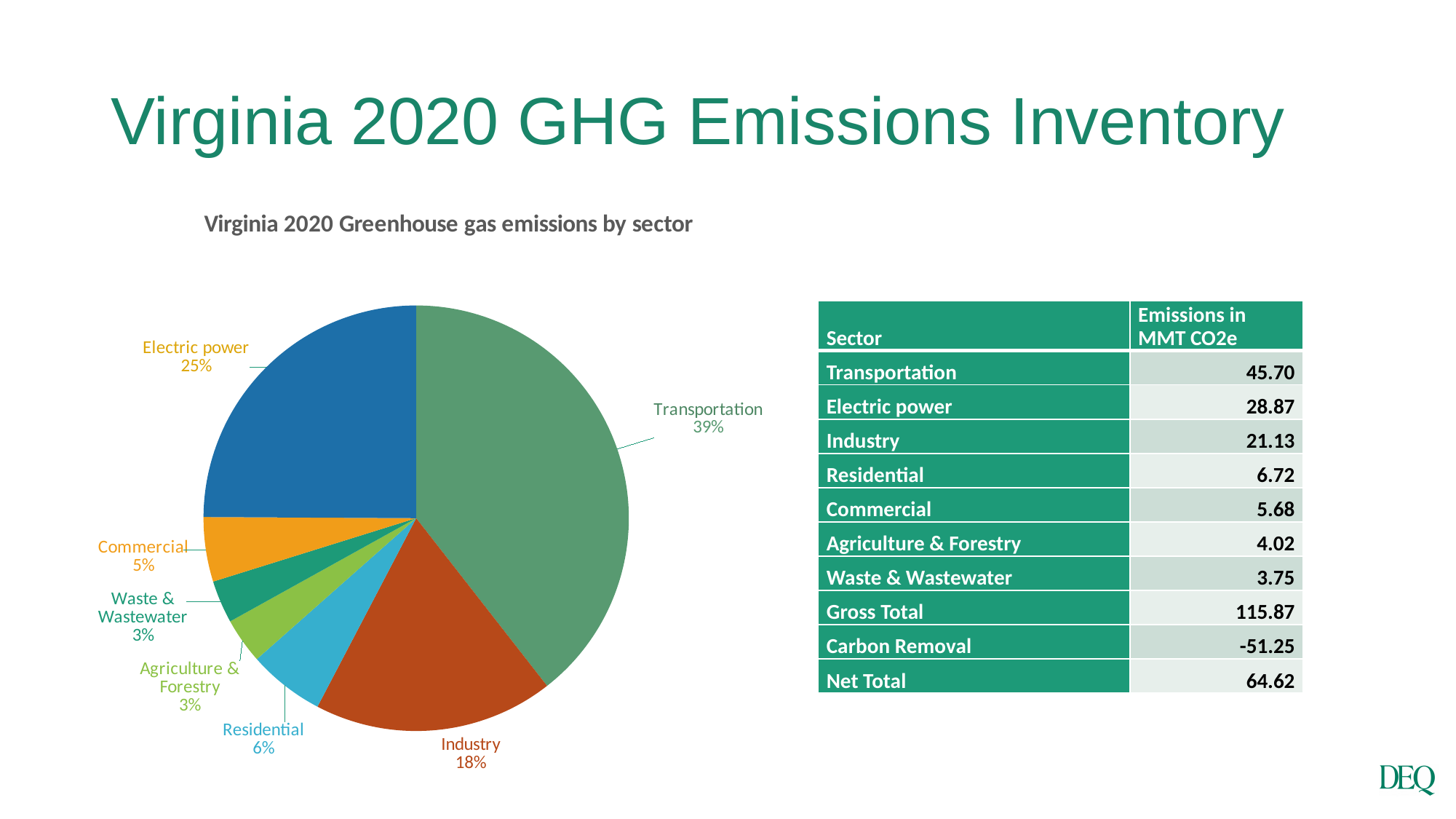
Which sector has the larger share, Commercial or Residential? Residential Which sector has the largest slice of the pie? Transportation How many sectors are shown in the pie chart? 7 What percentage of emissions does the Electric power slice represent? 25% What is the difference in percentage points between the Transportation and Electric power slices? 14 What is the combined percentage of the Industry and Residential slices? 24% What is the title of the pie chart? Virginia 2020 Greenhouse gas emissions by sector What share of the pie does Transportation account for? 39% What is the percentage shown for the Industry slice? 18% What percentage is shown for Waste & Wastewater? 3% What percentage is shown for Residential? 6% What type of chart is shown on the slide? Pie chart